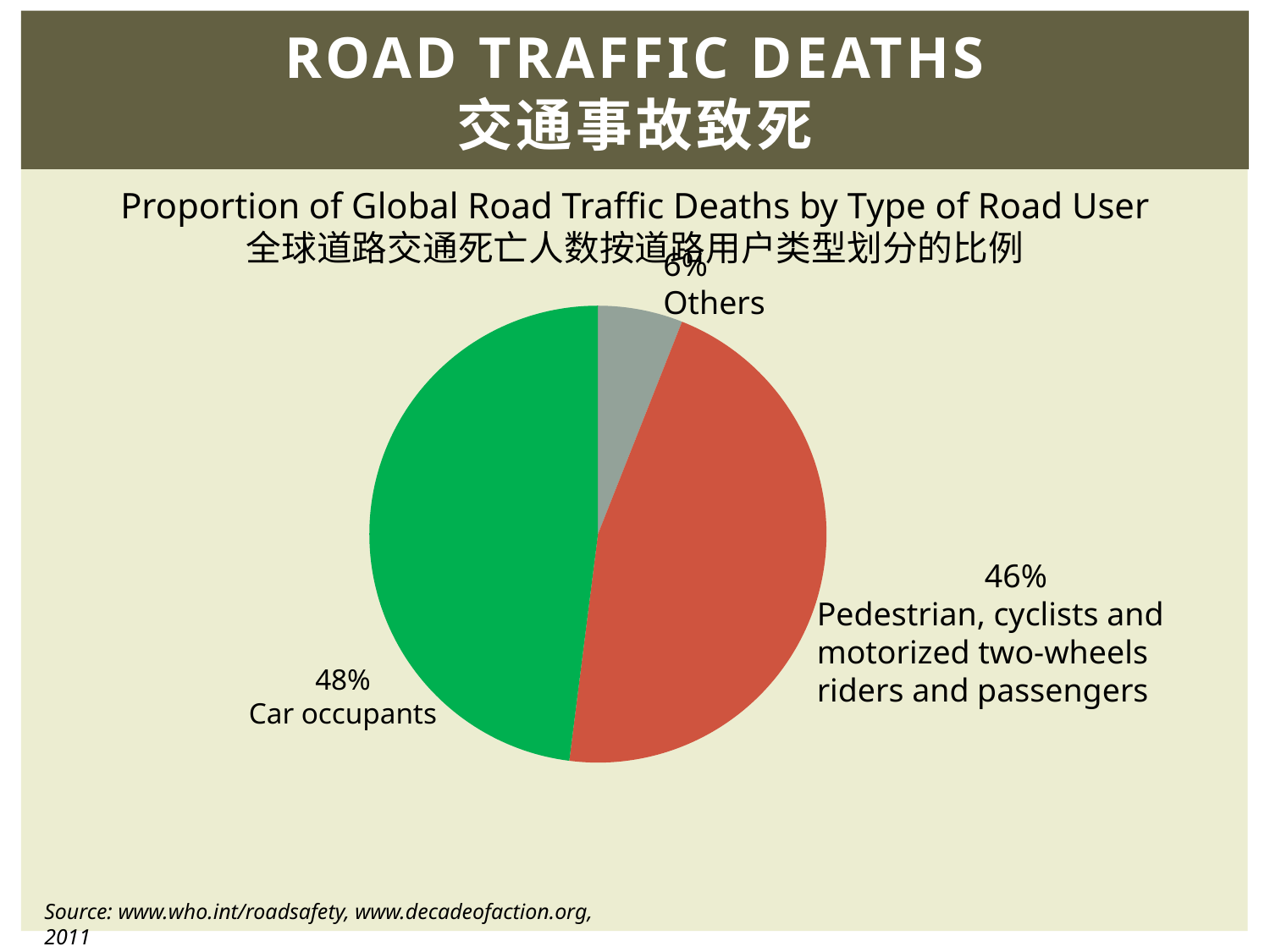
What share of global road traffic deaths is attributed to car occupants? 48% What type of chart is shown on the slide? Pie chart What is the title of the pie chart? Proportion of Global Road Traffic Deaths by Type of Road User What colour is the Car occupants slice? Green What share of global road traffic deaths is attributed to pedestrians, cyclists and motorized two-wheels riders and passengers? 46% What is the difference in percentage points between the Car occupants share and the Others share? 42 Which road user type accounts for the smallest share of global road traffic deaths? Others Which road user type accounts for the largest share of global road traffic deaths? Car occupants How many slices does the pie chart have? 3 What is the difference in percentage points between the Car occupants share and the Pedestrian, cyclists and motorized two-wheels riders and passengers share? 2 Which is larger: the share for Car occupants or the share for Others? Car occupants What share of global road traffic deaths is attributed to Others? 6%